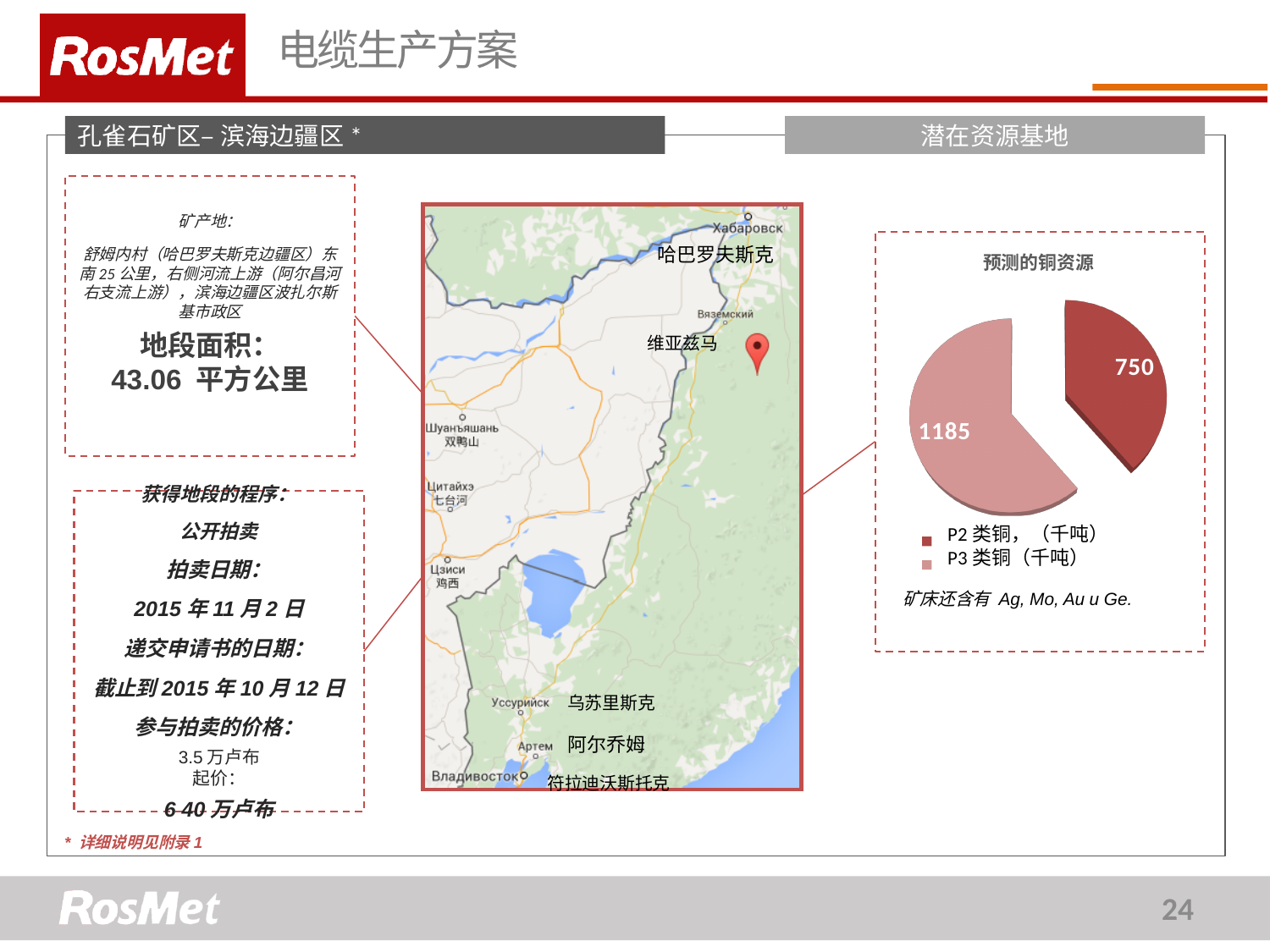
In the pie chart 预测的铜资源, what is the value for P2 类铜 (千吨)? 750 In the pie chart 预测的铜资源, what colour is the P2 类铜 slice? dark red In the pie chart 预测的铜资源, which category has the smallest slice? P2 类铜 In the pie chart 预测的铜资源, what is the total of the two slices? 1935 In the pie chart 预测的铜资源, what is the value for P3 类铜 (千吨)? 1185 In the pie chart 预测的铜资源, what is the difference between the P3 类铜 value and the P2 类铜 value? 435 What kind of chart is shown under the heading 潜在资源基地? pie chart How many slices does the pie chart 预测的铜资源 have? 2 How many entries does the legend of the pie chart 预测的铜资源 list? 2 What is the title of the pie chart on the right side of the slide? 预测的铜资源 In the pie chart 预测的铜资源, which is larger: P2 类铜 or P3 类铜? P3 类铜 In the pie chart 预测的铜资源, which category has the largest slice? P3 类铜